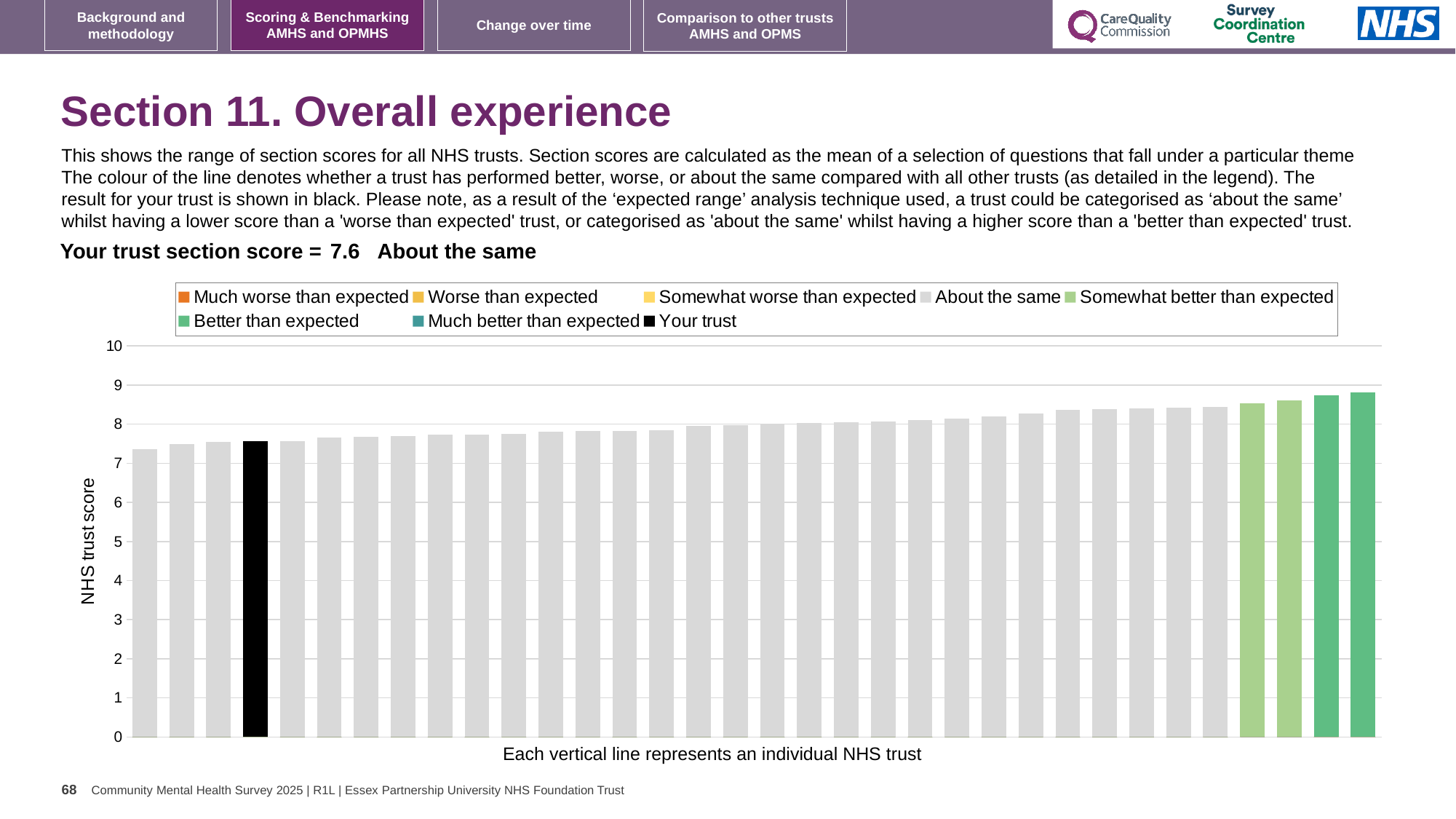
What is the title of the vertical axis? NHS trust score Is the value for your trust (the black bar) greater or less than 7? greater Which category is your trust's section score placed in? About the same Is the value of the leftmost bar greater or less than 8? less How many entries does the chart legend list? 8 Which is higher, the rightmost bar or the black bar for your trust? the rightmost bar Do the bar values rise or fall from left to right along the x axis? rise Is the value for your trust (the black bar) greater or less than 8? less How many bars are shown in the 'Better than expected' (darker green) colour? 2 What is the section score for your trust? 7.6 What kind of chart is shown on the slide? bar chart